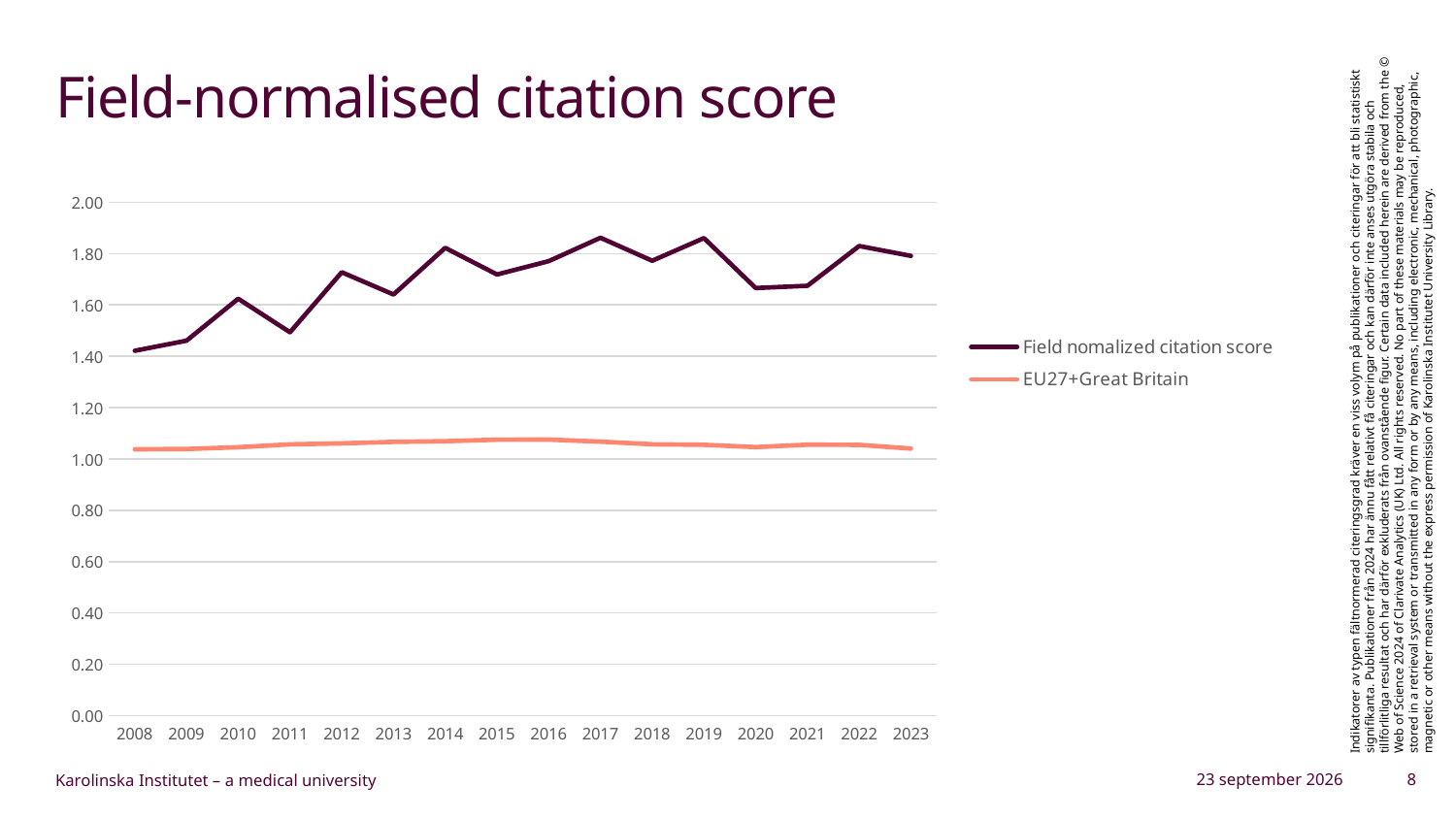
In which year is the Field nomalized citation score lowest? 2008 What kind of chart is shown on the slide? line chart Which series is drawn in orange? EU27+Great Britain In 2015, which series has the higher value, Field nomalized citation score or EU27+Great Britain? Field nomalized citation score How many years are plotted along the x axis? 16 Is the Field nomalized citation score for 2017 greater or less than 1.80? greater What is the title of the chart? Field-normalised citation score Which is larger, the Field nomalized citation score in 2010 or in 2011? 2010 Is the Field nomalized citation score for 2011 greater or less than 1.60? less How many series does the legend list? 2 Does the Field nomalized citation score overall rise or fall from 2008 to 2023? rise Is the EU27+Great Britain value for 2023 greater or less than 1.20? less